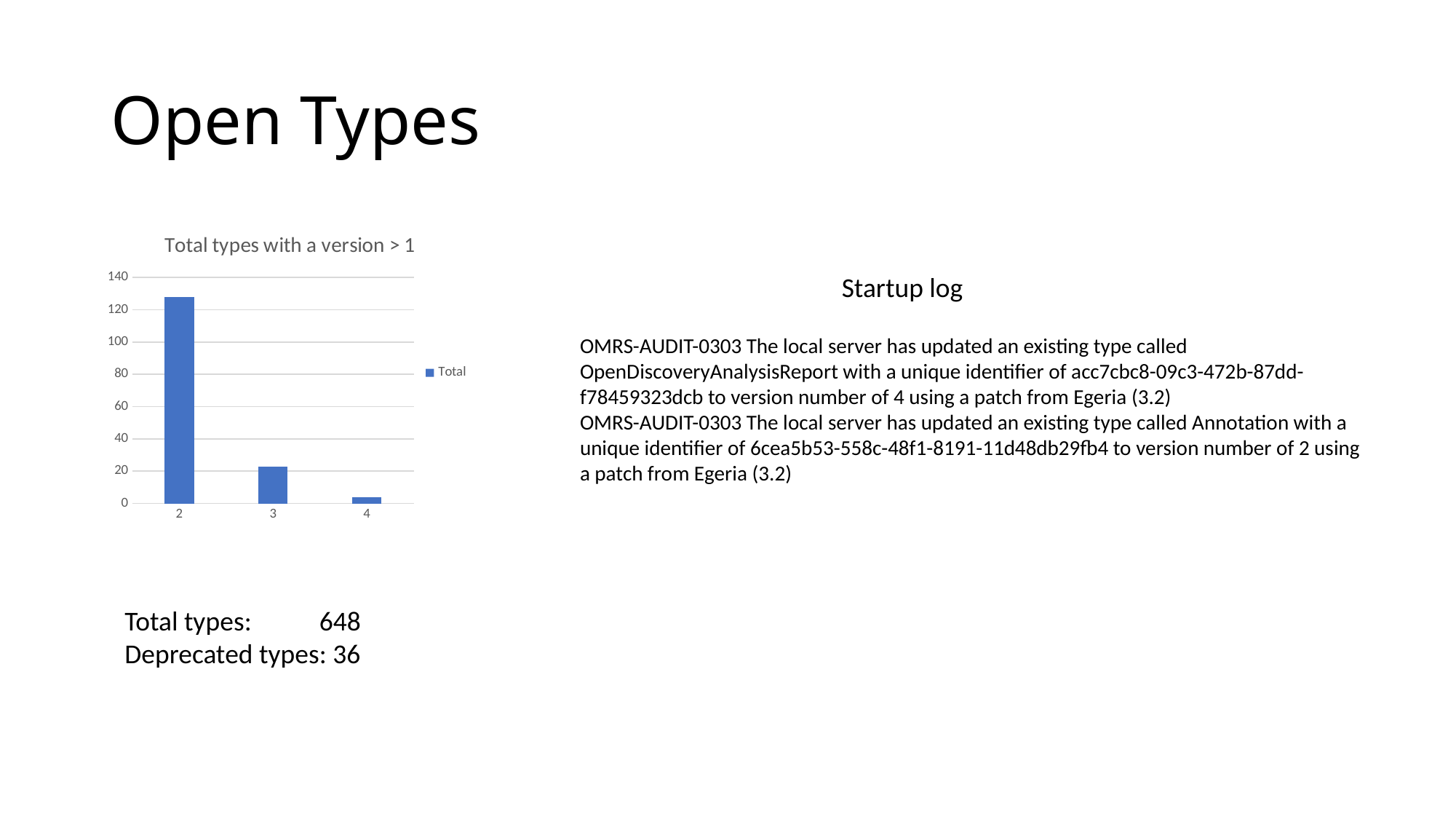
What kind of chart is shown on the slide? bar chart Is the value for category 3 greater or less than 40? less Is the value for category 2 greater or less than 120? greater What is the title of the chart? Total types with a version > 1 How many series does the chart legend list? 1 Which is larger, the value for category 2 or the value for category 3? 2 Is the value for category 4 greater or less than 20? less Which category has the lowest value in the chart? 4 Do the values rise or fall as the version number increases along the x axis? fall What is the name of the series in the chart legend? Total Which category has the highest value in the chart? 2 How many categories are shown on the x axis of the chart? 3